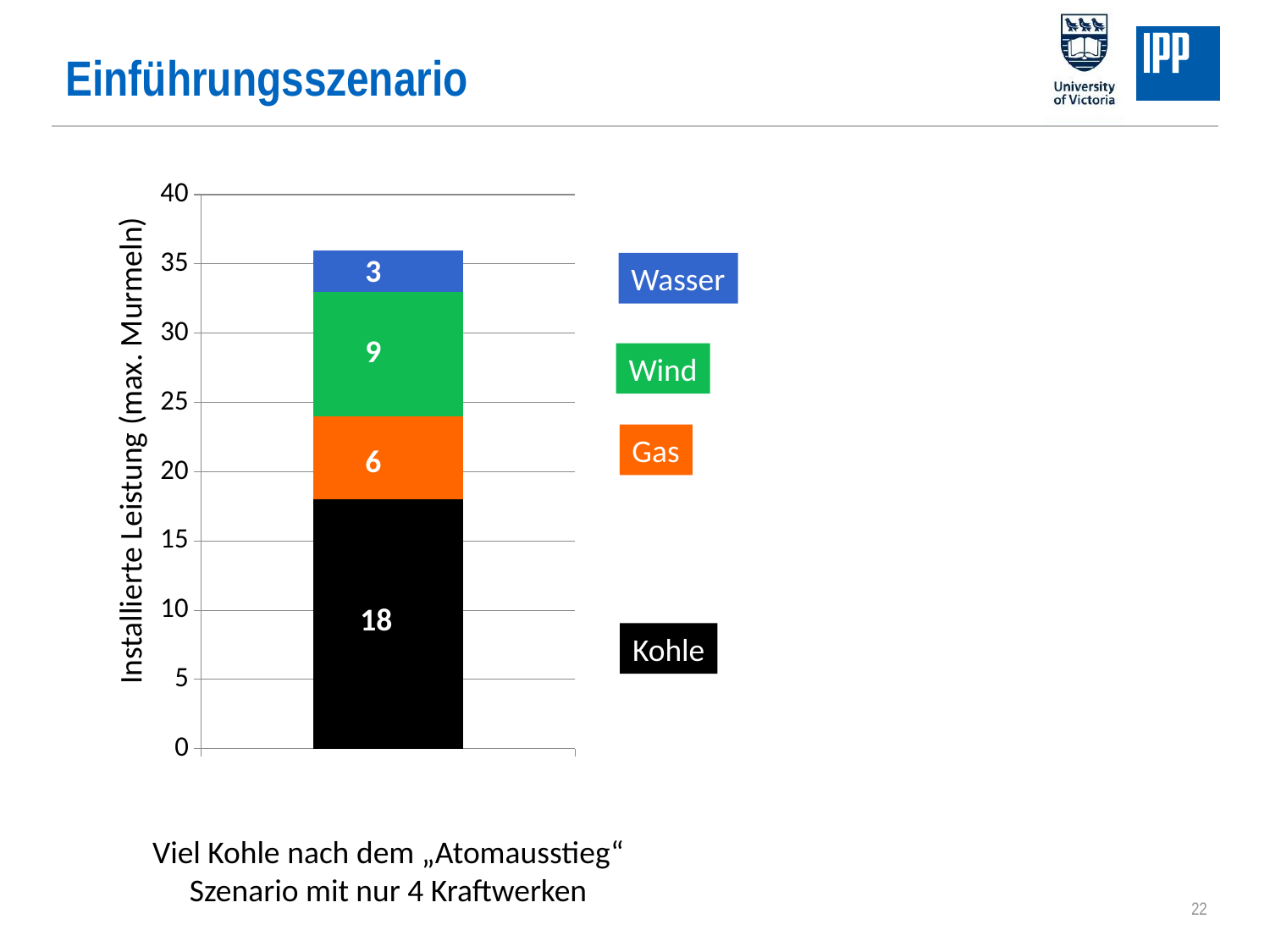
What is the value for Wind in the stacked bar? 9 What is the label of the y axis? Installierte Leistung (max. Murmeln) What is the value for Kohle in the stacked bar? 18 What is the difference between the Kohle value and the Wind value? 9 What kind of chart is shown on the slide? Stacked bar chart What is the value for Gas in the stacked bar? 6 What is the total of the stacked bar? 36 What is the value for Wasser in the stacked bar? 3 Which energy source has the largest segment in the stacked bar? Kohle Which energy source has the smallest segment in the stacked bar? Wasser Which is larger, the value for Gas or the value for Wind? Wind How many energy sources are shown in the stacked bar? 4